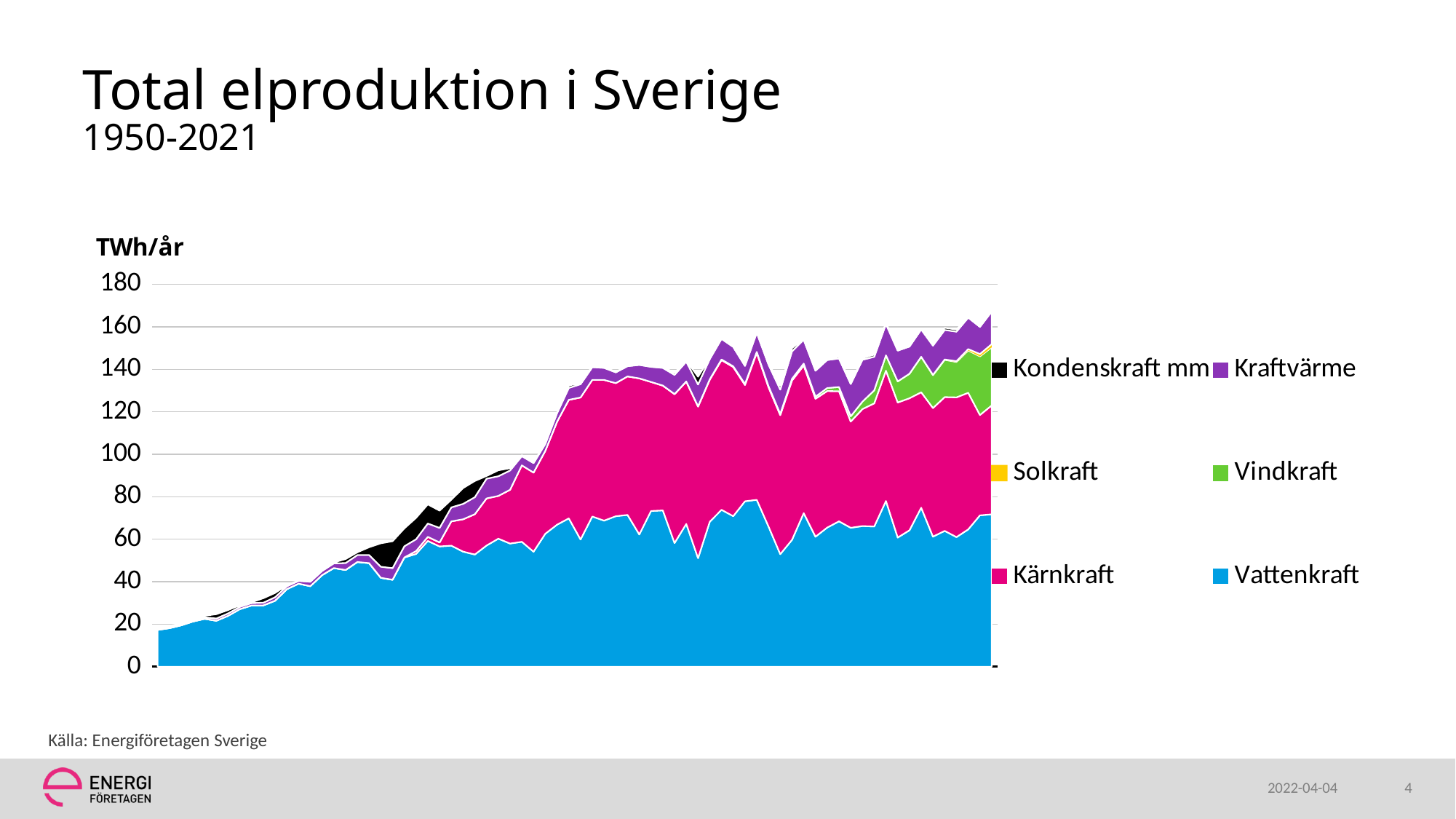
Does total electricity production rise or fall overall from the left to the right of the chart? Rise Is the Vattenkraft value at the right end of the chart greater or less than 100 TWh/år? less Which series forms the bottom layer of the stacked area chart? Vattenkraft At the right end of the chart, which is larger, the Vattenkraft layer or the Kärnkraft layer? Vattenkraft Is the total production at the right end of the chart greater or less than 140 TWh/år? greater What kind of chart is shown on the slide? Stacked area chart How many series does the legend list? 6 What is the highest value shown on the y axis? 180 What unit is shown on the y axis of the chart? TWh/år Is the total production at the left end of the chart greater or less than 40 TWh/år? less